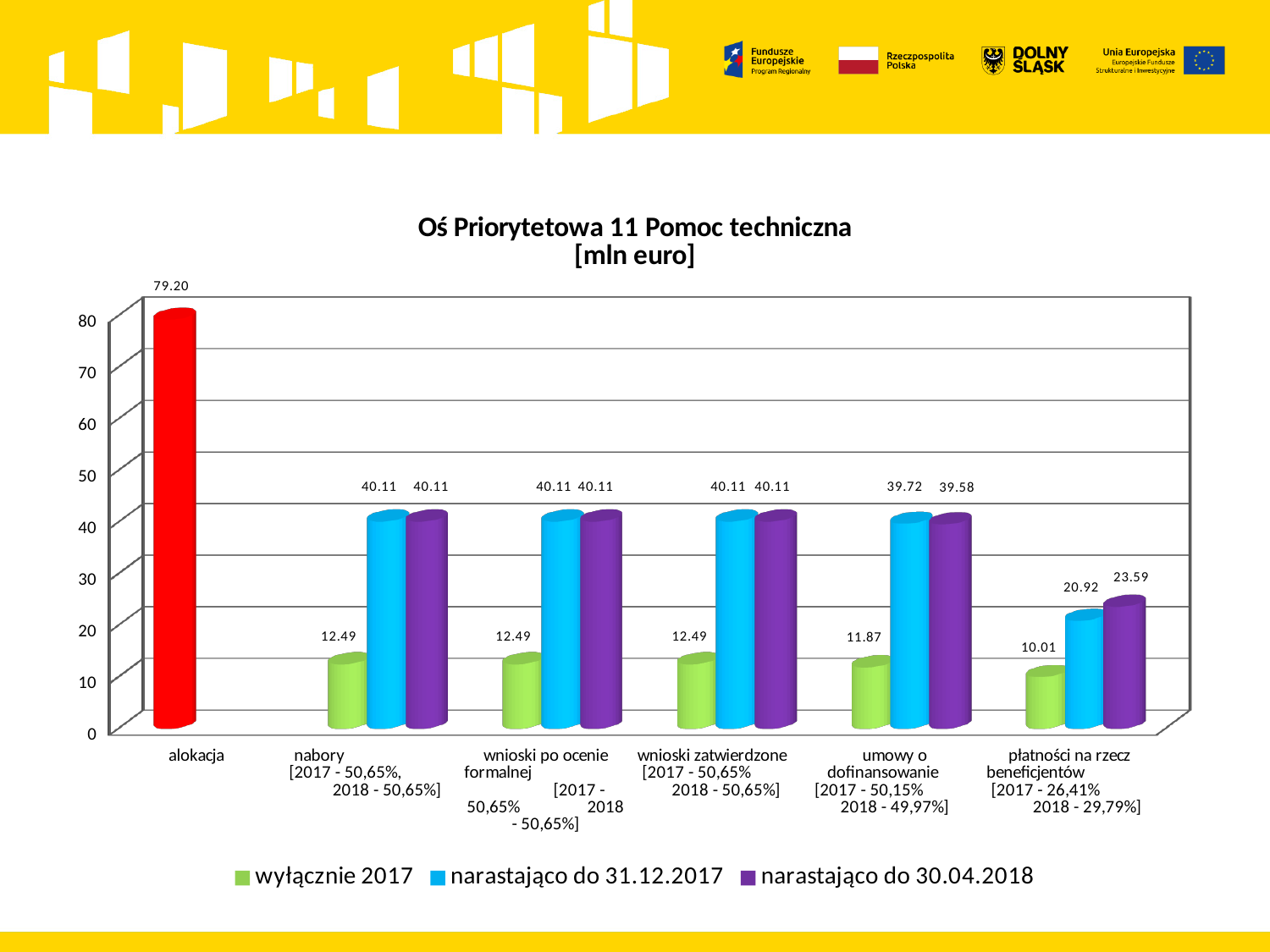
What is the difference between the 'narastająco do 30.04.2018' and 'narastająco do 31.12.2017' values for 'płatności na rzecz beneficjentów'? 2.67 How many series does the legend list? 3 What type of chart is shown on the slide? bar chart Which category has the lowest 'wyłącznie 2017' value? płatności na rzecz beneficjentów How many categories are shown on the x axis? 6 Is the 'narastająco do 31.12.2017' value for 'płatności na rzecz beneficjentów' greater or less than 30? less What is the value of the alokacja bar? 79.20 For 'umowy o dofinansowanie', which is larger: 'narastająco do 31.12.2017' or 'narastająco do 30.04.2018'? narastająco do 31.12.2017 What is the value for 'wyłącznie 2017' in the 'umowy o dofinansowanie' category? 11.87 What is the value for 'narastająco do 31.12.2017' in the 'nabory' category? 40.11 Which category has the highest value on the chart? alokacja What is the value for 'narastająco do 30.04.2018' in the 'płatności na rzecz beneficjentów' category? 23.59